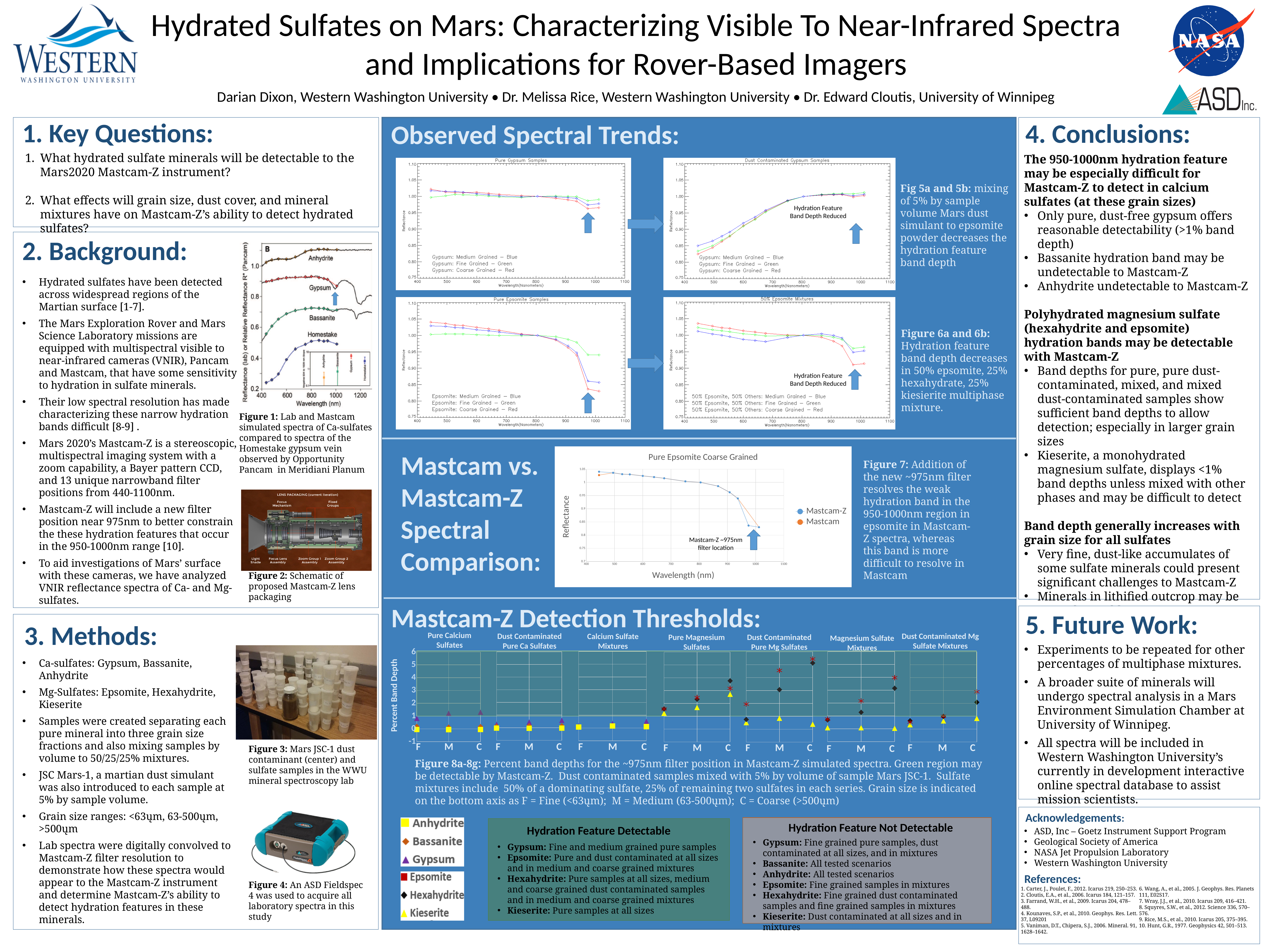
In Figure 1, which mineral has the highest reflectance curve? Anhydrite In the 'Mastcam-Z Detection Thresholds' chart, is the Anhydrite value for fine-grained Pure Calcium Sulfates greater or less than 1? less In the 'Pure Epsomite Samples' chart, does reflectance rise or fall as wavelength increases from 400 to 1000 nm? Fall In the 'Mastcam-Z Detection Thresholds' chart, how many sample groups (panels) are shown along the x axis? 7 In the 'Pure Gypsum Samples' chart, which colour represents the medium grained gypsum? Blue In the 'Dust Contaminated Gypsum Samples' chart, does reflectance rise or fall as wavelength increases from 400 to 900 nm? Rise In Figure 1, which spectrum has the lowest reflectance? Homestake In the 'Pure Gypsum Samples' chart, how many grain-size series are plotted? 3 What is the y-axis label of the 'Mastcam-Z Detection Thresholds' chart? Percent Band Depth In the 'Mastcam-Z Detection Thresholds' chart, is the Epsomite value for coarse-grained Pure Magnesium Sulfates greater or less than 4? less In the 'Mastcam-Z Detection Thresholds' chart, how many minerals does the legend list? 6 In the 'Pure Epsomite Coarse Grained' chart, how many series does the legend list? 2